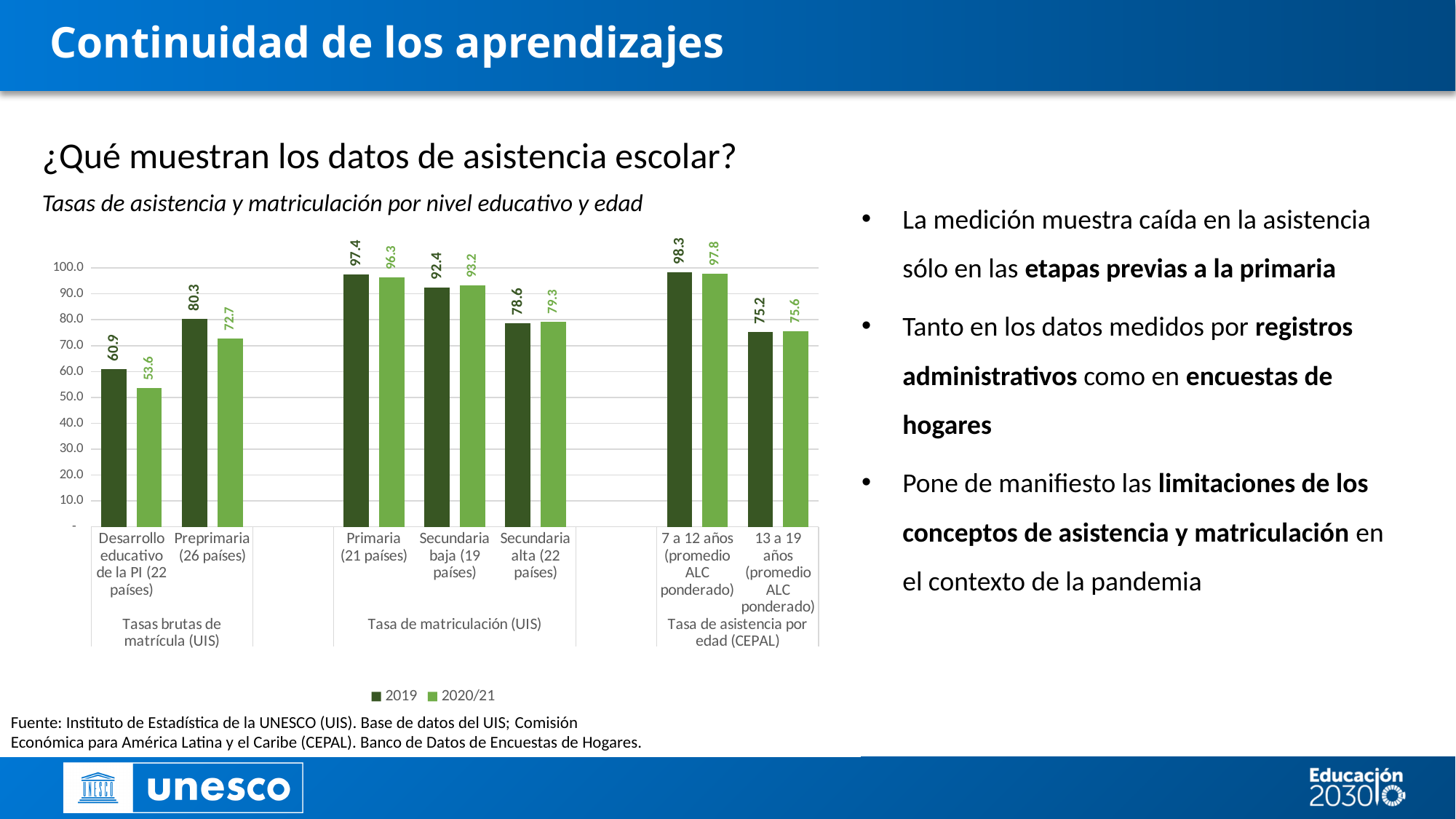
What is the difference between the 2019 and 2020/21 values for Preprimaria (26 países)? 7.6 How many categories are shown on the x axis of the chart? 7 Which category has the lowest 2020/21 value? Desarrollo educativo de la PI (22 países) What is the 2019 value for Preprimaria (26 países)? 80.3 For Primaria (21 países), which is larger: the 2019 value or the 2020/21 value? 2019 What is the 2020/21 value for Secundaria baja (19 países)? 93.2 What is the difference between the 2019 and 2020/21 values for Desarrollo educativo de la PI (22 países)? 7.3 What is the 2020/21 value for Desarrollo educativo de la PI (22 países)? 53.6 What type of chart is shown on the slide? Bar chart What is the 2019 value for 7 a 12 años (promedio ALC ponderado)? 98.3 Which category has the highest 2019 value? 7 a 12 años (promedio ALC ponderado) How many series does the legend list? 2